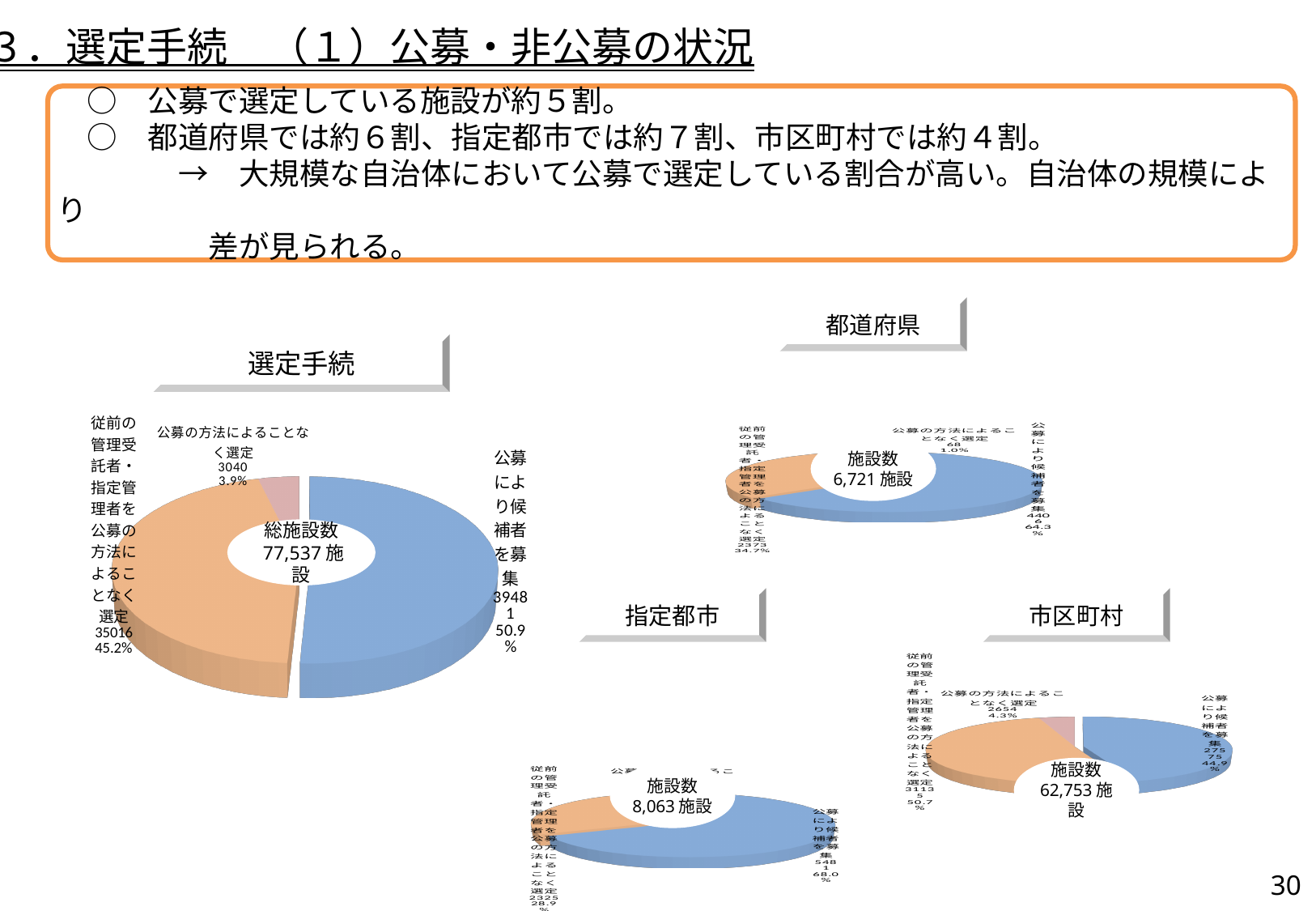
In the 市区町村 chart, what percentage share does 公募の方法によることなく選定 have? 4.3% In the 都道府県 chart, what percentage share does 公募により候補者を募集 have? 64.3% In the 選定手続 chart, what is the total number of facilities shown in the centre (総施設数)? 77,537 施設 In the 選定手続 chart, what is the value for 公募の方法によることなく選定? 3040 In the 指定都市 chart, what percentage share does 公募により候補者を募集 have? 68.0% In the 都道府県 chart, what is the number of facilities shown in the centre (施設数)? 6,721 施設 In the 市区町村 chart, which is larger: the share for 公募により候補者を募集 or the share for 従前の管理受託者・指定管理者を公募の方法によることなく選定? 従前の管理受託者・指定管理者を公募の方法によることなく選定 In the 選定手続 chart, which category has the smallest slice? 公募の方法によることなく選定 What kind of chart is the 選定手続 chart on the left of the slide? pie chart In the 指定都市 chart, what is the number of facilities shown in the centre (施設数)? 8,063 施設 In the 選定手続 chart, how many slices does the pie have? 3